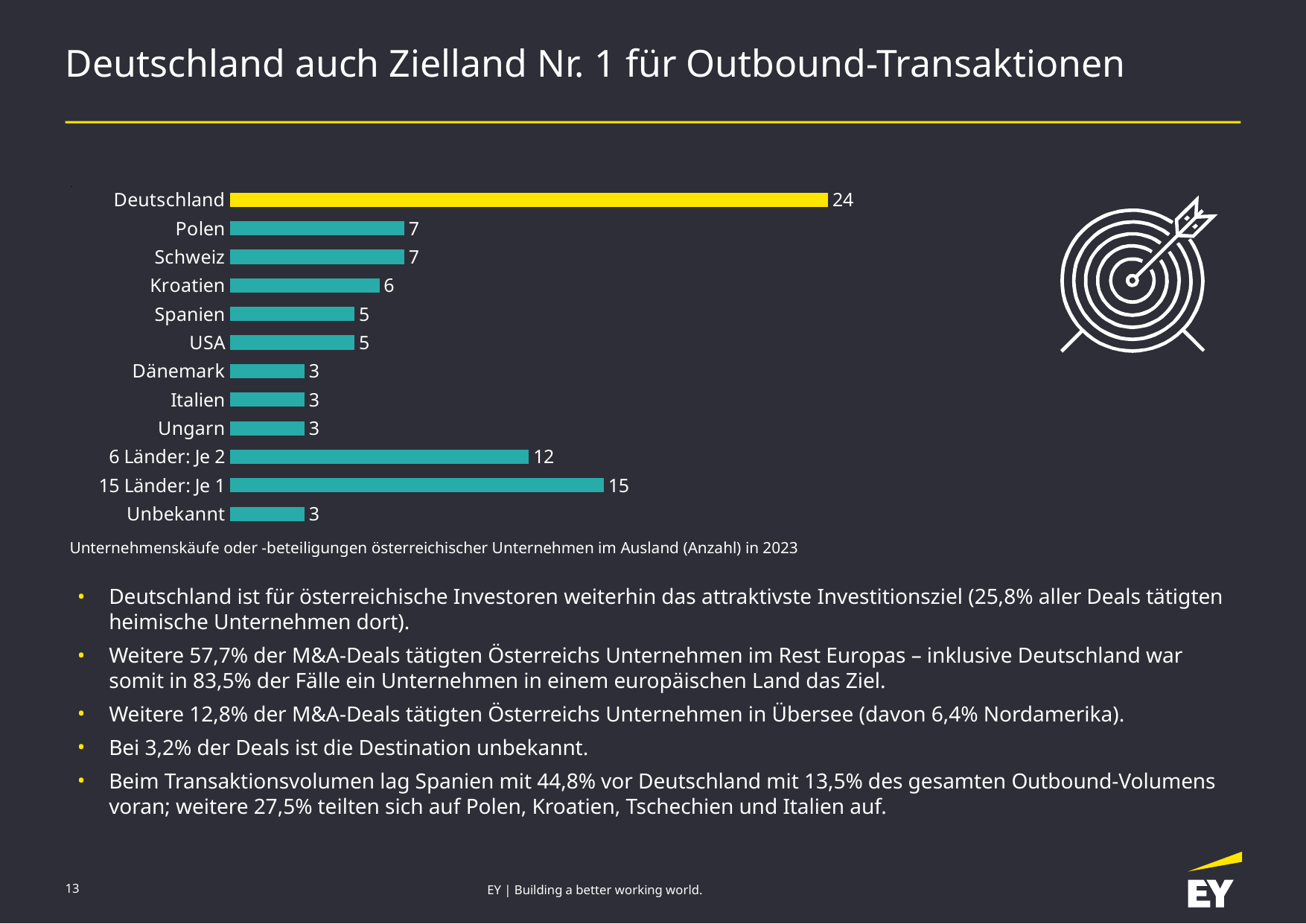
What kind of chart is shown on the slide? Bar chart What is the difference between the values for Deutschland and Polen? 17 What is the difference between the values for 15 Länder: Je 1 and 6 Länder: Je 2? 3 What is the value for Deutschland? 24 What is the value for 15 Länder: Je 1? 15 What is the value for Kroatien? 6 Which bar in the chart is coloured yellow rather than teal? Deutschland What is the value for Unbekannt? 3 How many categories are shown in the chart? 12 Which category has the highest value? Deutschland Which is larger, the value for Kroatien or the value for Spanien? Kroatien Which is larger, the value for USA or the value for Dänemark? USA